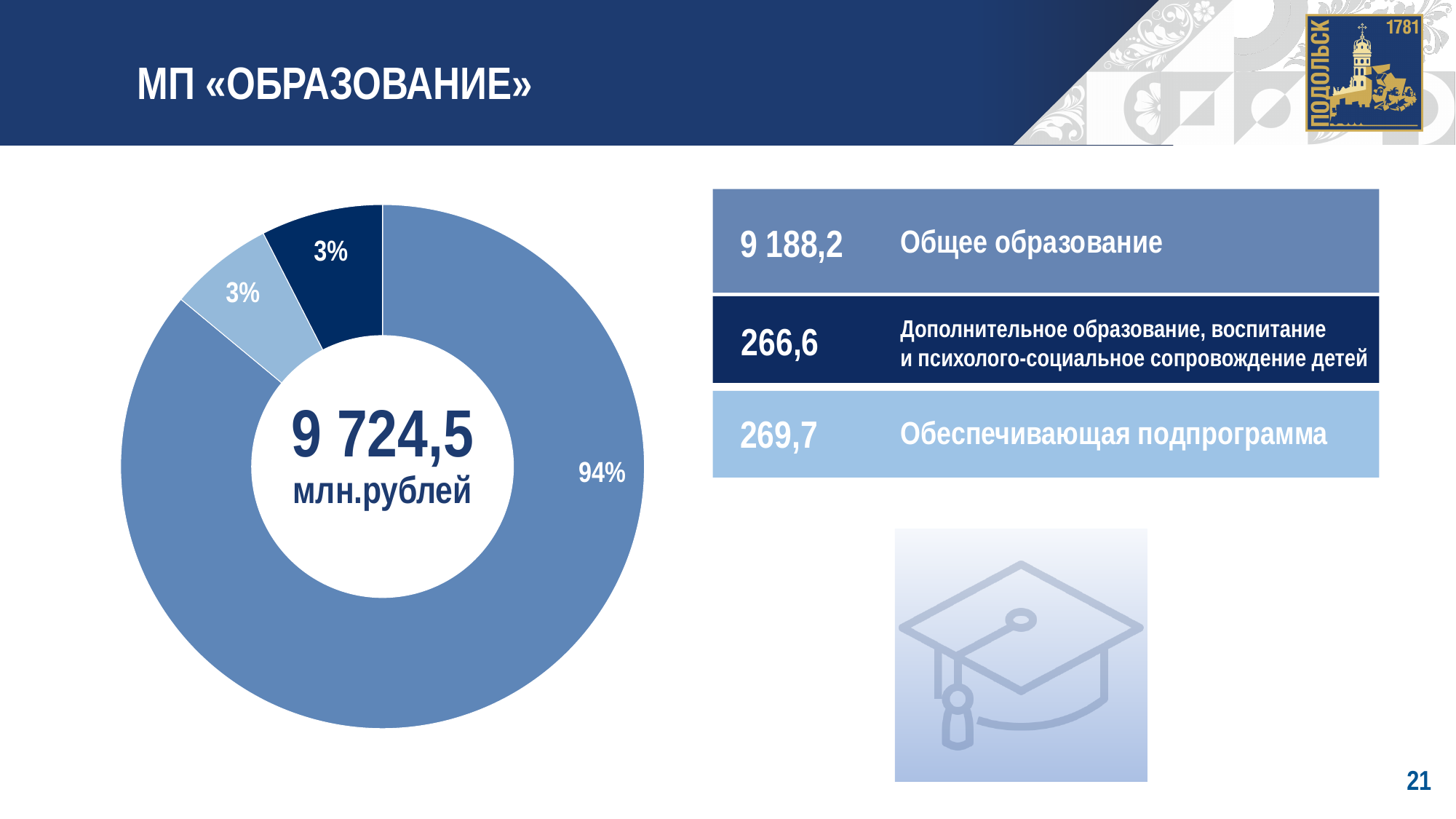
Which is larger: the value for «Обеспечивающая подпрограмма» or for «Дополнительное образование, воспитание и психолого-социальное сопровождение детей»? Обеспечивающая подпрограмма Which category has the lowest value? Дополнительное образование, воспитание и психолого-социальное сопровождение детей Which category has the highest value? Общее образование What share of the donut chart does the largest slice represent? 94% What total amount is shown in the centre of the donut chart? 9 724,5 млн.рублей What is the title of the slide containing the chart? МП «ОБРАЗОВАНИЕ» What is the value shown for «Дополнительное образование, воспитание и психолого-социальное сопровождение детей»? 266,6 How many slices does the donut chart have? 3 What is the value shown for «Общее образование»? 9 188,2 What is the difference between the values for «Обеспечивающая подпрограмма» and «Дополнительное образование, воспитание и психолого-социальное сопровождение детей»? 3,1 What kind of chart is shown on the slide? Pie chart (donut) What is the value shown for «Обеспечивающая подпрограмма»? 269,7